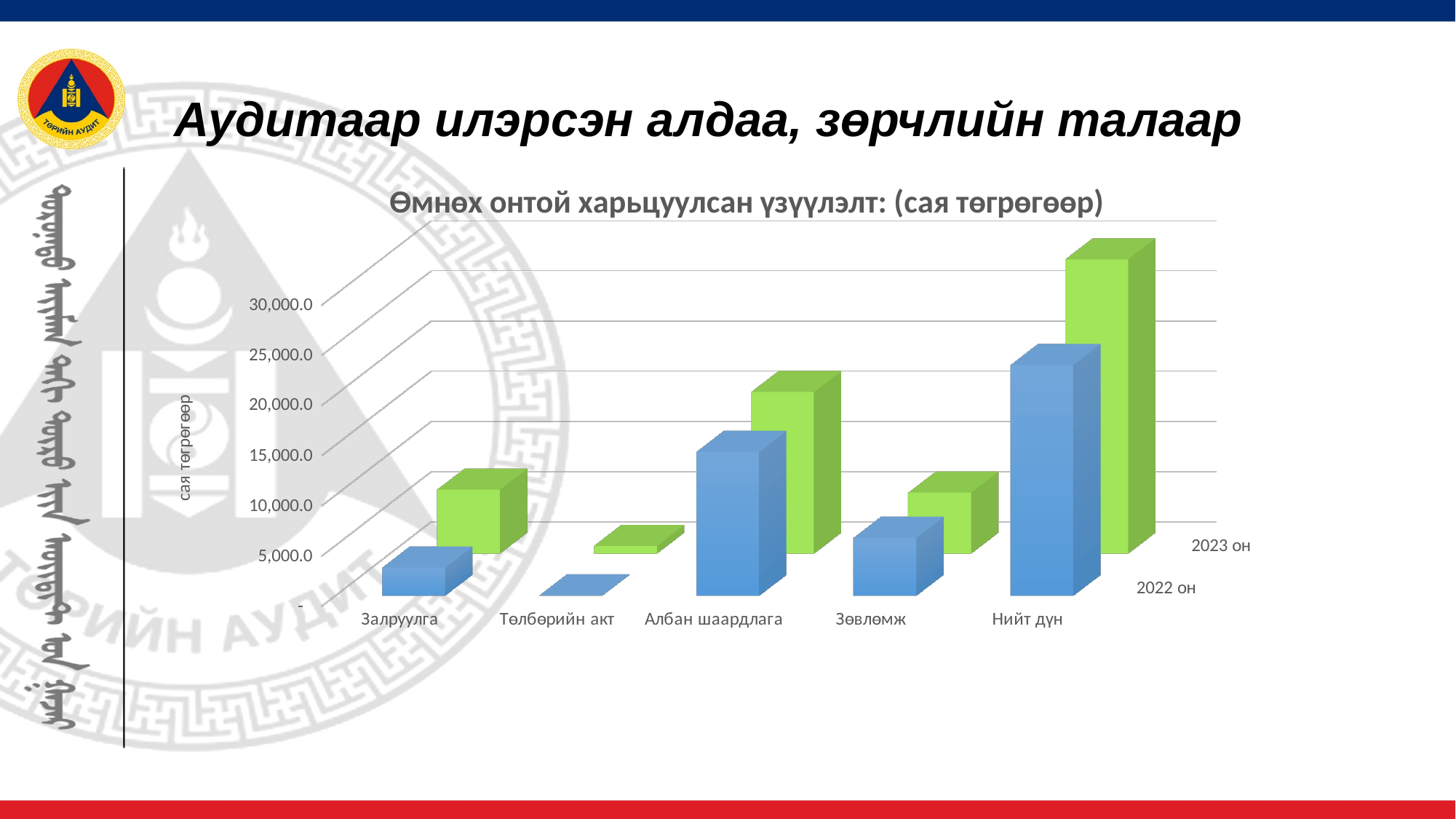
What is the title of the chart? Өмнөх онтой харьцуулсан үзүүлэлт: (сая төгрөгөөр) How many categories are shown on the x axis of the chart? 5 What are the two series names shown in the chart? 2022 он and 2023 он Which category has the lowest value for the 2022 он series? Төлбөрийн акт How many series does the chart show? 2 Is the value for Төлбөрийн акт in the 2022 он series greater or less than 5,000.0? less Is the value for Албан шаардлага in the 2022 он series greater or less than 10,000.0? greater For the 2022 он series, which is larger: Албан шаардлага or Зөвлөмж? Албан шаардлага What kind of chart is shown on the slide? bar chart For Залруулга, which series has the larger value: 2022 он or 2023 он? 2023 он Which category has the highest value for the 2023 он series? Нийт дүн Which category has the lowest value for the 2023 он series? Төлбөрийн акт